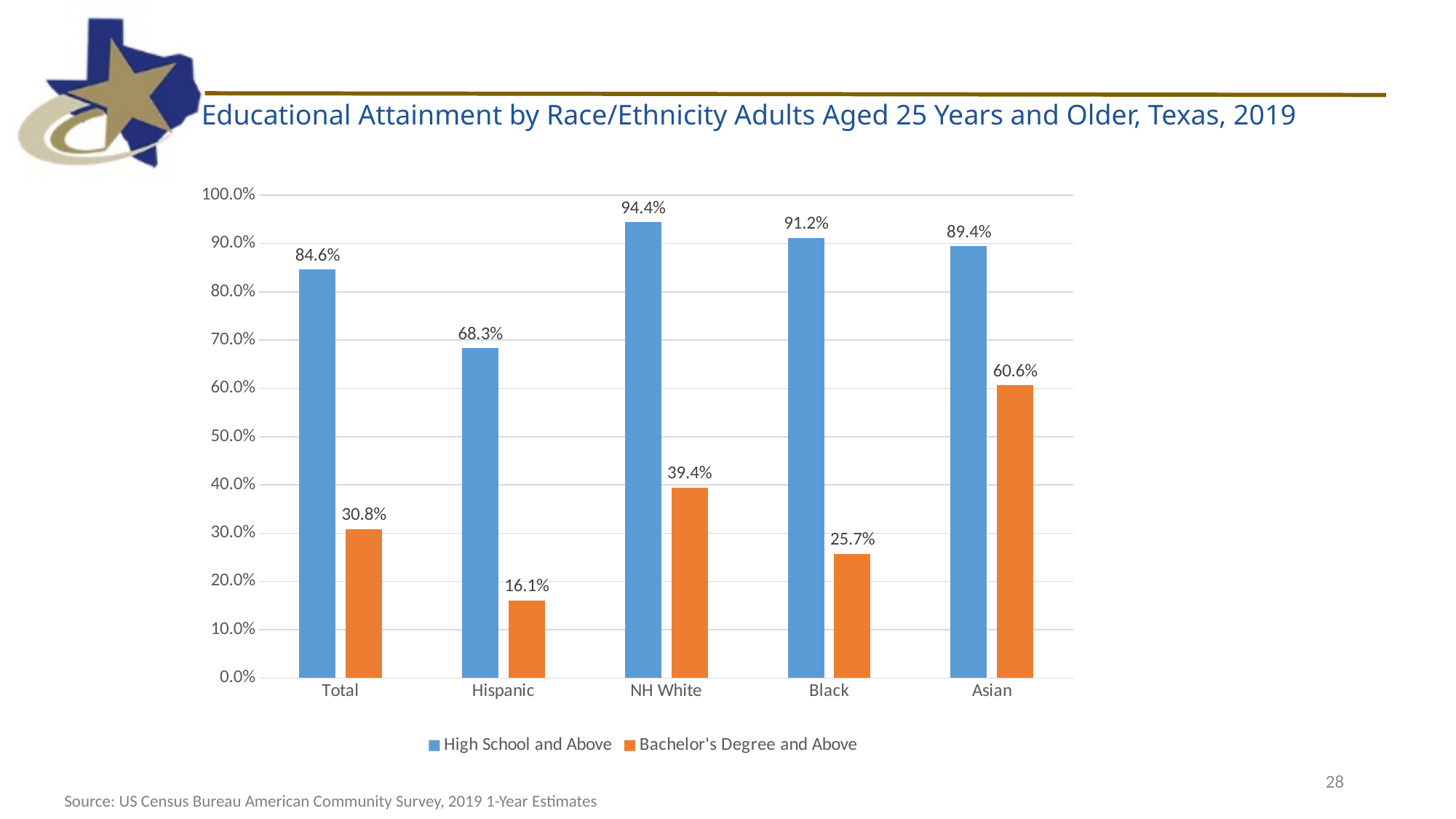
Which category has the lowest Bachelor's Degree and Above value? Hispanic What is the difference between the High School and Above and Bachelor's Degree and Above values for NH White? 55.0% How many categories are shown on the x axis? 5 Which category has the highest High School and Above value? NH White How many series does the legend list? 2 Is the High School and Above value for Asian greater or less than 80.0%? greater What kind of chart is shown on the slide? Bar chart What colour are the Bachelor's Degree and Above bars? Orange What is the Bachelor's Degree and Above value for Black? 25.7% Which is larger: the Bachelor's Degree and Above value for Total or for Black? Total What is the Bachelor's Degree and Above value for Asian? 60.6% What is the High School and Above value for Hispanic? 68.3%